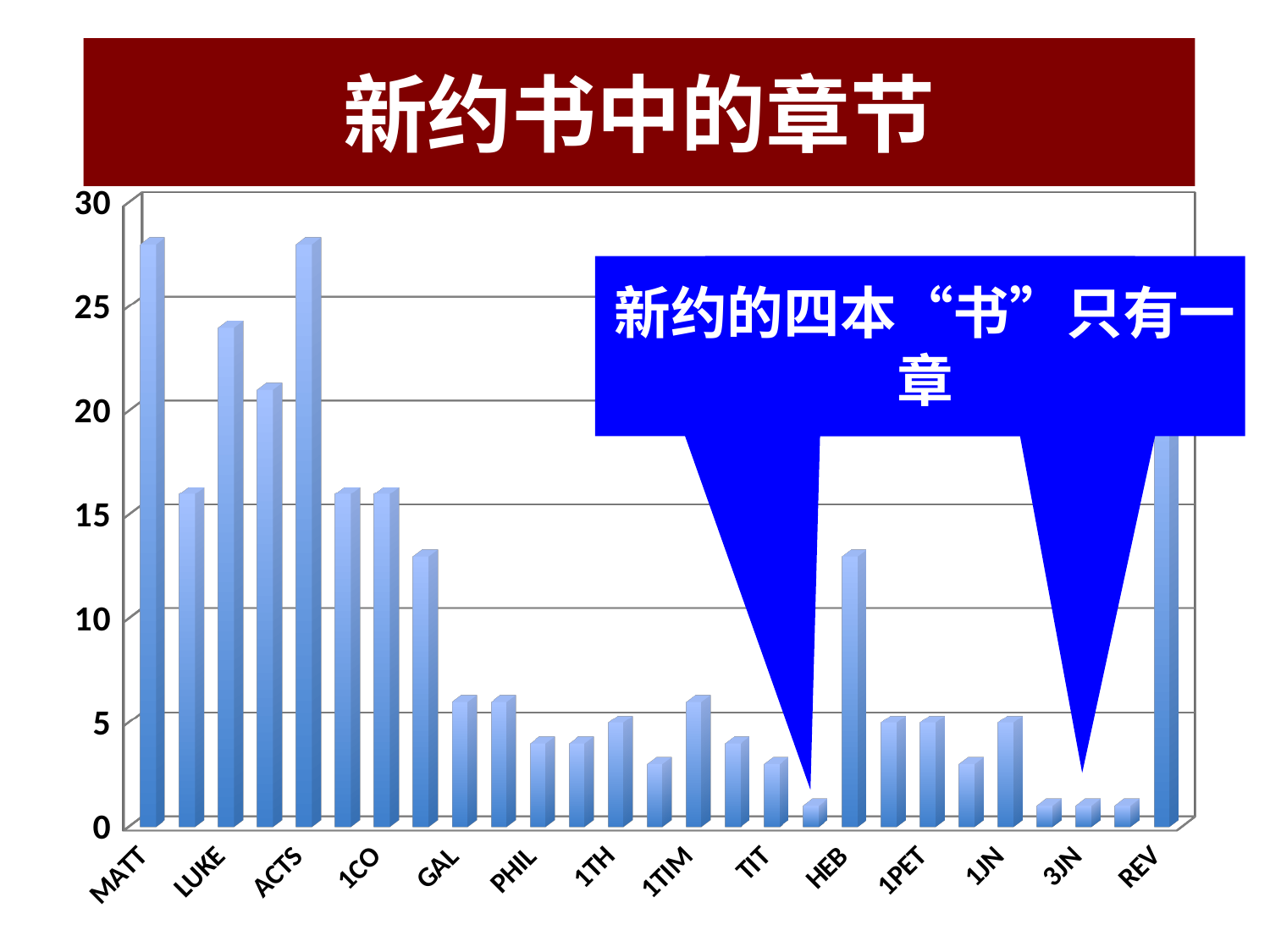
How many bars are plotted in the chart? 27 Is the value for LUKE greater or less than 25? less Is the value for TIT greater or less than 5? less What is the title of the chart? 新约书中的章节 Is the value for MATT greater or less than 25? greater Which is larger, the value for HEB or the value for GAL? HEB Which is larger, the value for MATT or the value for LUKE? MATT What does the blue callout on the chart say? 新约的四本“书”只有一章 What kind of chart is shown on the slide? bar chart